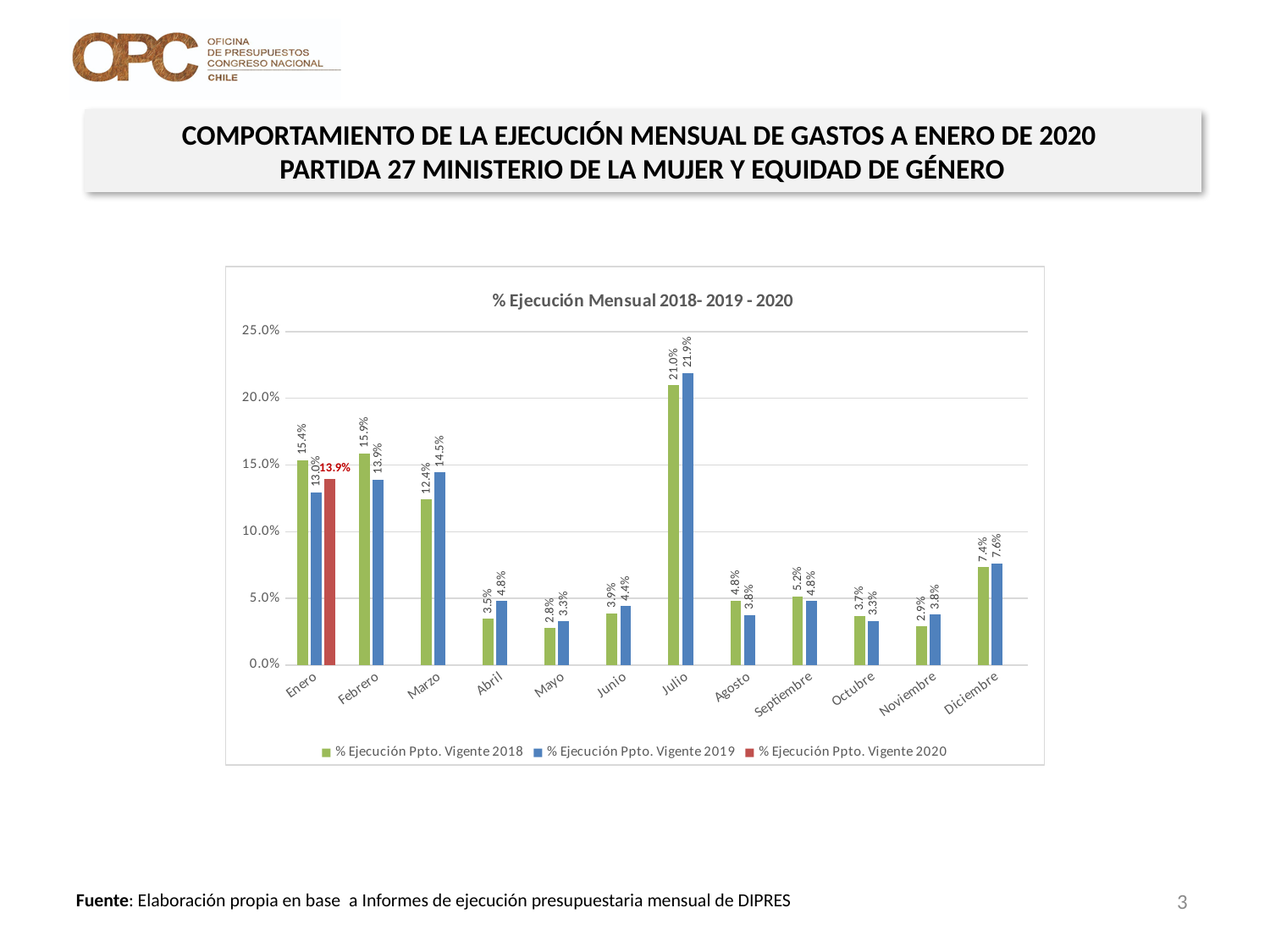
What is the value for % Ejecución Ppto. Vigente 2018 in Septiembre? 5.2% In Marzo, which series is larger: % Ejecución Ppto. Vigente 2018 or % Ejecución Ppto. Vigente 2019? % Ejecución Ppto. Vigente 2019 What is the value for % Ejecución Ppto. Vigente 2019 in Julio? 21.9% What is the title of the chart? % Ejecución Mensual 2018- 2019 - 2020 What is the value for % Ejecución Ppto. Vigente 2020 in Enero? 13.9% How many series does the legend list? 3 How many months are shown on the x axis? 12 What kind of chart is shown on the slide? Bar chart Is the value for % Ejecución Ppto. Vigente 2018 in Diciembre greater or less than 10.0%? less Which month has the highest value for % Ejecución Ppto. Vigente 2018? Julio Which month has the lowest value for % Ejecución Ppto. Vigente 2018? Mayo What is the difference between the 2019 and 2018 values in Julio? 0.9 percentage points